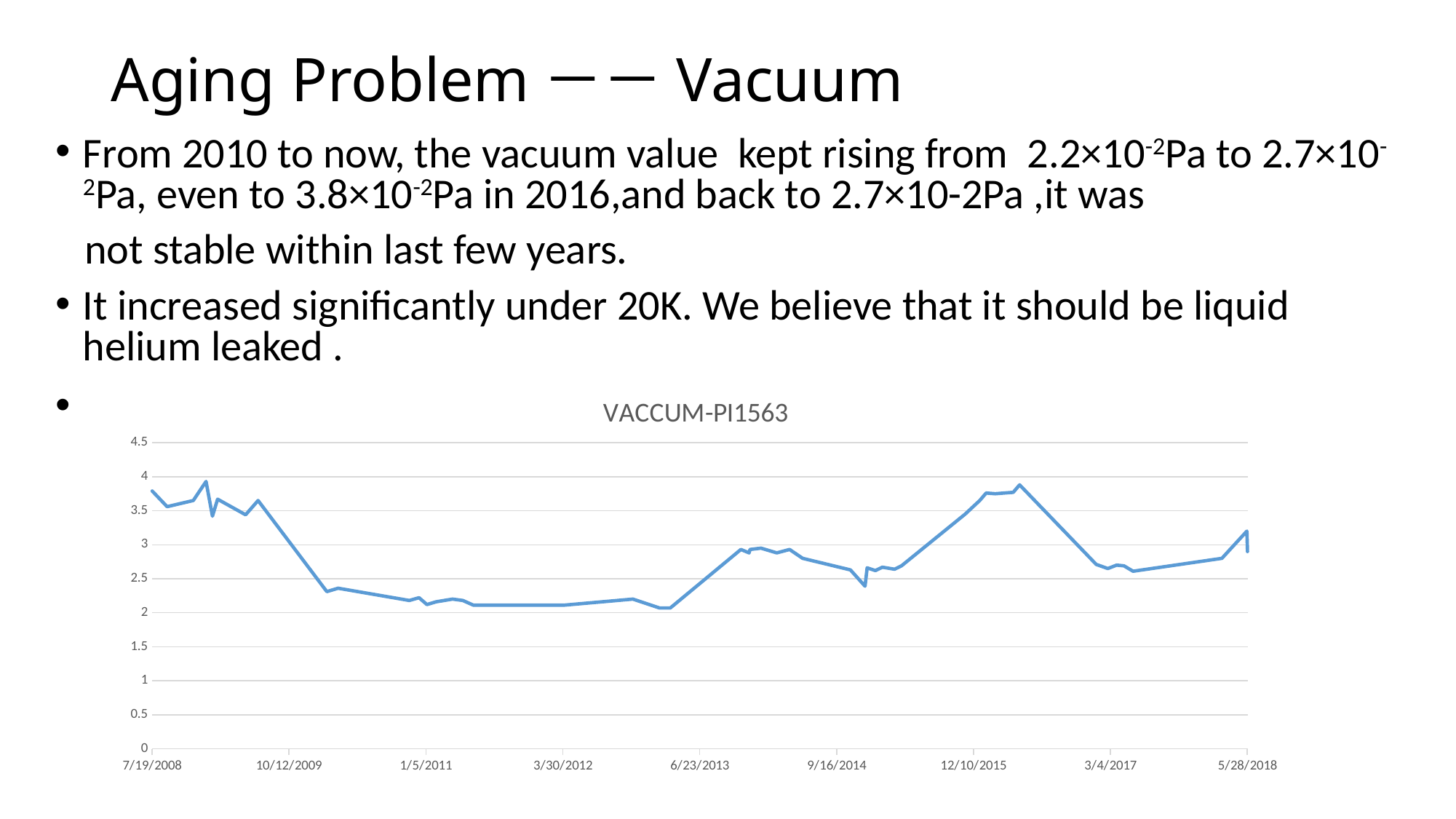
Does the line rise or fall between 12/10/2015 and 3/4/2017? fall What is the highest tick value shown on the y axis of the chart? 4.5 What kind of chart is shown on the slide? line chart Is the value at 3/30/2012 greater or less than 2.5? less Does the line rise or fall between 10/12/2009 and 1/5/2011? fall Is the value at 7/19/2008 greater or less than 3.5? greater Is the value at 1/5/2011 greater or less than 2.5? less What is the title of the chart? VACCUM-PI1563 How many lines are plotted on the chart? 1 How many date labels are shown on the x axis of the chart? 9